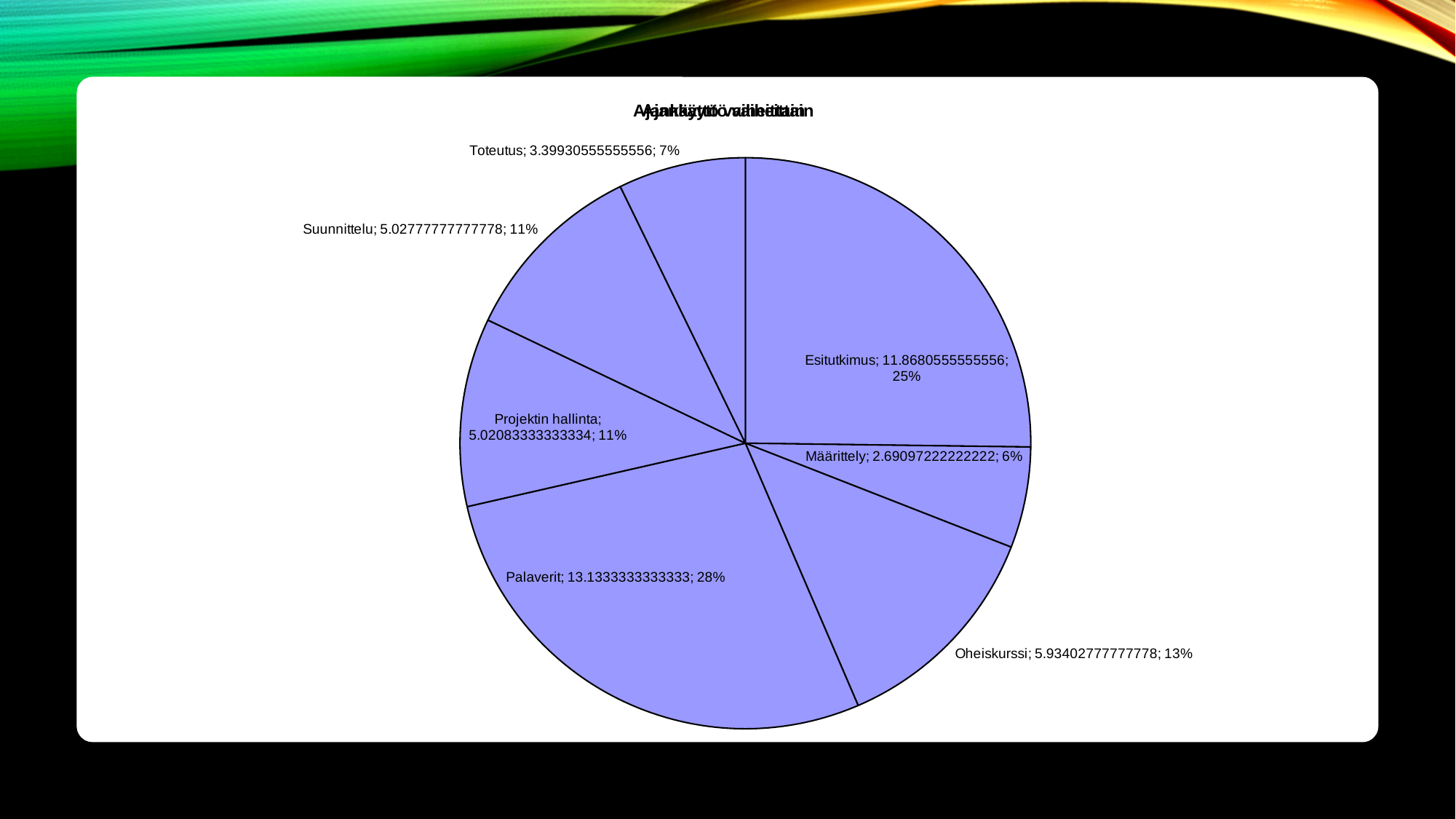
What share of the pie does Esitutkimus represent? 25% What share of the pie does Toteutus represent? 7% What value is shown for the Oheiskurssi slice? 5.93402777777778 Which category has the largest slice of the pie? Palaverit Which category has the smallest slice of the pie? Määrittely How many slices does the pie chart have? 7 By how many percentage points does the Palaverit share exceed the Esitutkimus share? 3 What kind of chart is shown on the slide? pie chart What value is shown for the Määrittely slice? 2.69097222222222 Which is larger, the Esitutkimus slice or the Oheiskurssi slice? Esitutkimus What value is shown for the Esitutkimus slice? 11.8680555555556 What value is shown for the Palaverit slice? 13.1333333333333